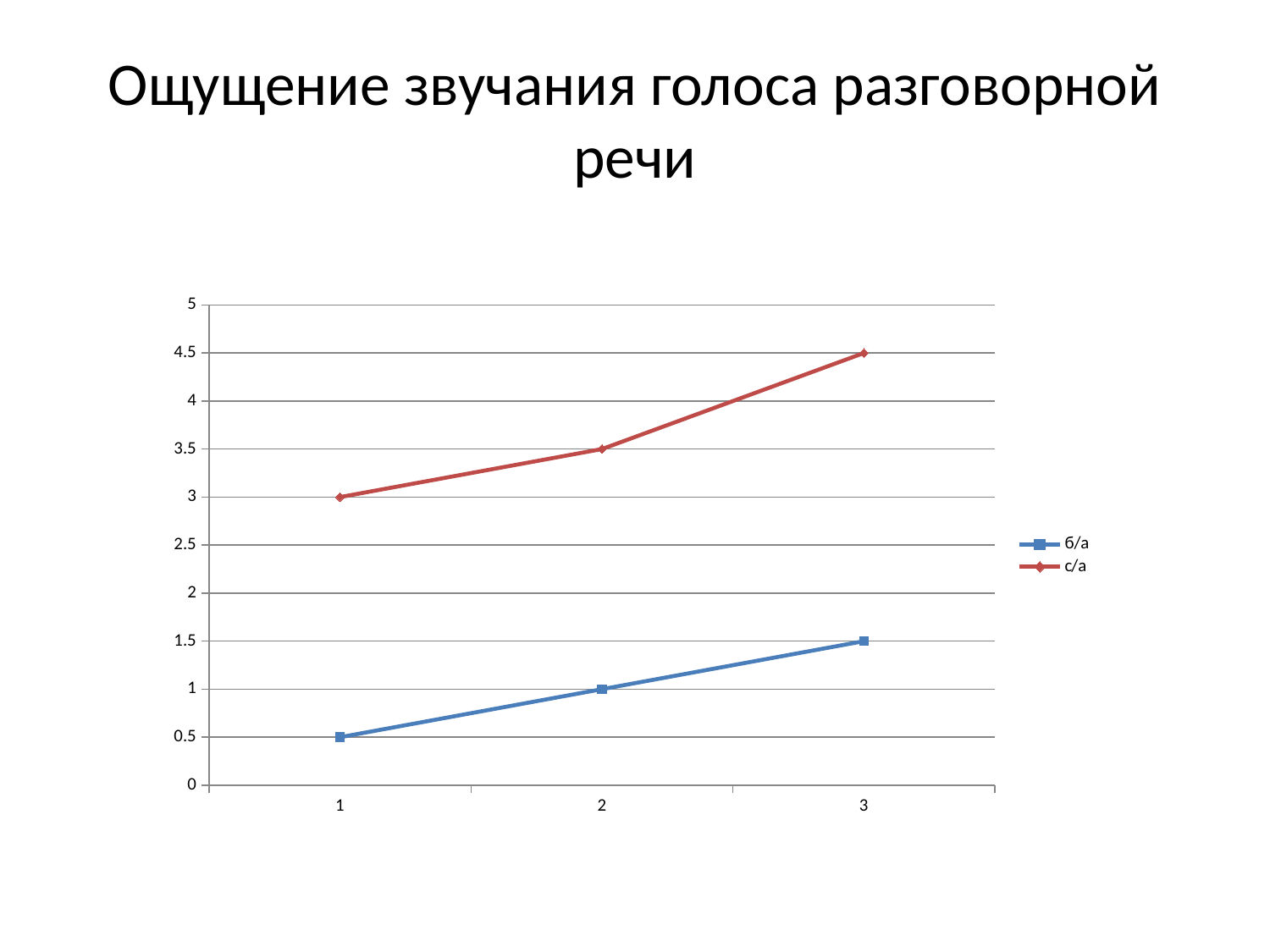
What is the value of the б/а series at x = 2? 1 What is the title of the chart on the slide? Ощущение звучания голоса разговорной речи What is the difference between the с/а and б/а values at x = 2? 2.5 What is the value of the б/а series at x = 1? 0.5 Which series has the higher value at x = 3, б/а or с/а? с/а Is the value of the б/а series at x = 3 greater or less than 2? less What is the value of the с/а series at x = 1? 3 What is the value of the с/а series at x = 3? 4.5 How many series does the legend list? 2 What kind of chart is shown on the slide? line chart How many points are plotted along the x axis for each series? 3 Do the values of the с/а series rise or fall from x = 1 to x = 3? rise